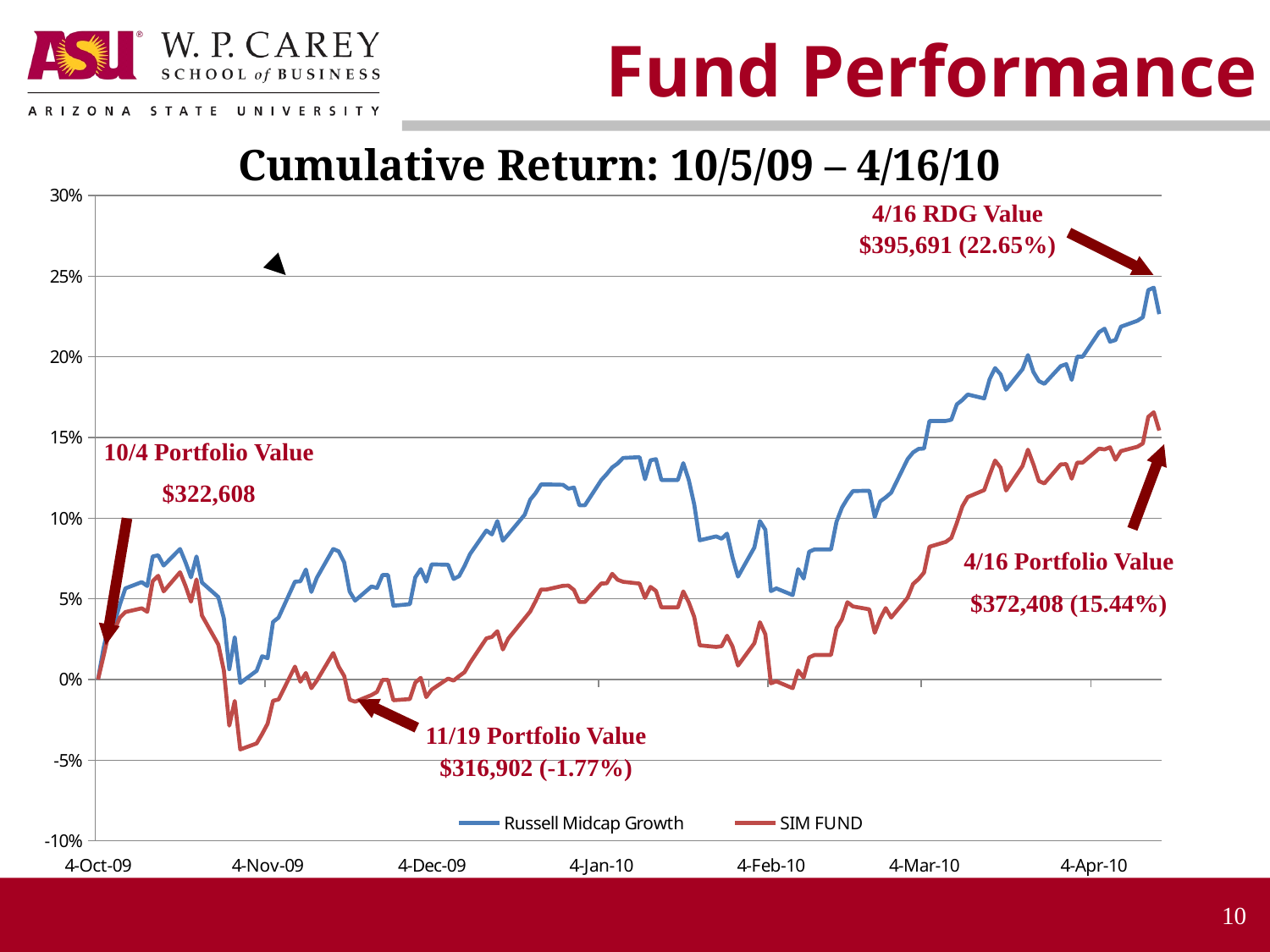
Is the Russell Midcap Growth cumulative return at 4-Mar-10 greater or less than 10%? greater What is the 4/16 RDG Value shown on the chart? $395,691 (22.65%) Which two series are listed in the chart's legend? Russell Midcap Growth and SIM FUND What is the 4/16 Portfolio Value shown on the chart? $372,408 (15.44%) What is the title of the chart? Cumulative Return: 10/5/09 – 4/16/10 What is the 11/19 Portfolio Value shown on the chart? $316,902 (-1.77%) Which series has the higher cumulative return at the end of the period, Russell Midcap Growth or SIM FUND? Russell Midcap Growth By how many percentage points does the 4/16 RDG return (22.65%) exceed the 4/16 Portfolio return (15.44%)? 7.21 percentage points What is the 10/4 Portfolio Value shown on the chart? $322,608 Overall, do the cumulative returns rise or fall from 4-Oct-09 to the end of the period? rise What kind of chart is shown on the slide? line chart How many series does the chart's legend list? 2